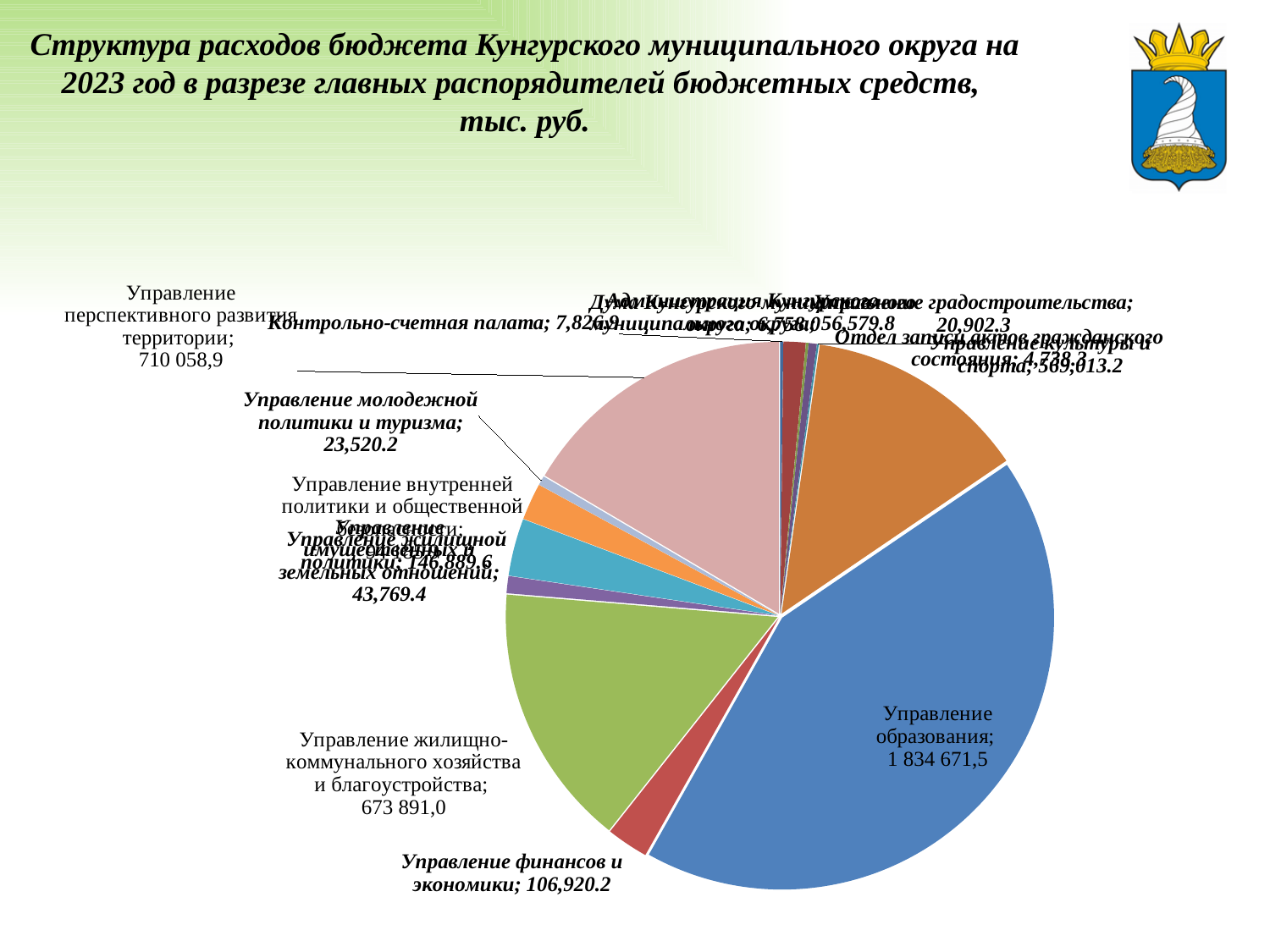
What is the value for Управление образования? 1 834 671,5 What is the value for Управление перспективного развития территории? 710 058,9 What is the value for Управление финансов и экономики? 106,920.2 Which category has the largest slice of the pie? Управление образования What is the value for Управление жилищной политики? 146,889.6 What is the value for Управление жилищно-коммунального хозяйства и благоустройства? 673 891,0 What is the value for Управление молодежной политики и туризма? 23,520.2 What kind of chart is shown on the slide? pie chart Which is larger: the value for Управление финансов и экономики or for Управление молодежной политики и туризма? Управление финансов и экономики In what units are the values in the chart expressed, according to the title? тыс. руб. Which is larger: the value for Управление перспективного развития территории or for Управление жилищно-коммунального хозяйства и благоустройства? Управление перспективного развития территории What is the difference between the values for Управление перспективного развития территории and Управление жилищно-коммунального хозяйства и благоустройства? 36 167,9